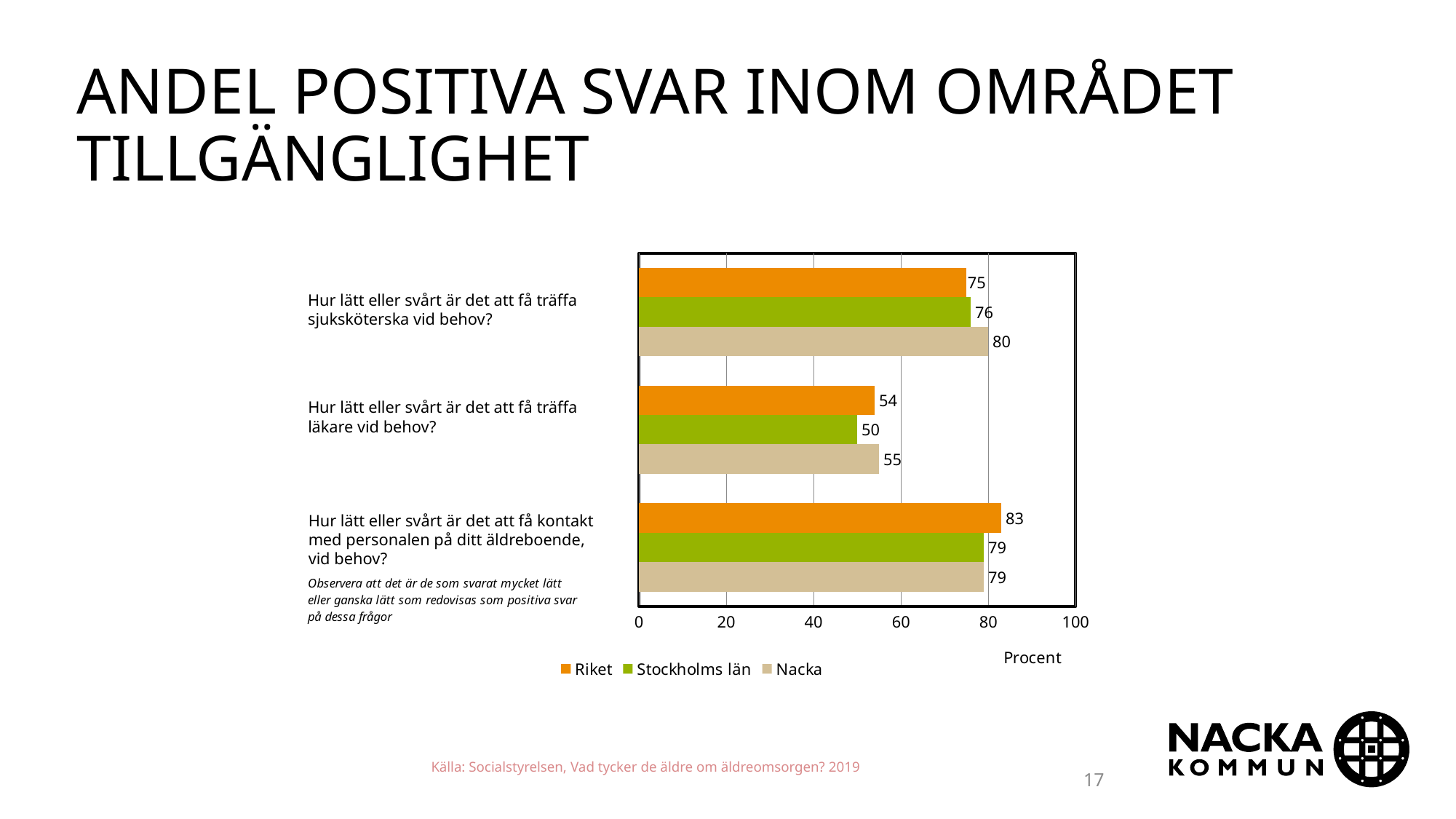
Which colour represents Riket in the legend? Orange Which is larger on the question 'Hur lätt eller svårt är det att få träffa läkare vid behov?': the value for Nacka or the value for Riket? Nacka What is the value for Nacka on the question 'Hur lätt eller svårt är det att få träffa sjuksköterska vid behov?' 80 How many series does the legend list? 3 How many questions (categories) are shown on the chart? 3 Which series has the highest value on the question 'Hur lätt eller svårt är det att få kontakt med personalen på ditt äldreboende, vid behov?' Riket What is the difference between the Nacka and Riket values on the question 'Hur lätt eller svårt är det att få träffa sjuksköterska vid behov?' 5 What kind of chart is shown on the slide? Bar chart What unit is shown on the x axis of the chart? Procent What is the value for Stockholms län on the question 'Hur lätt eller svårt är det att få kontakt med personalen på ditt äldreboende, vid behov?' 79 Which series has the lowest value on the question 'Hur lätt eller svårt är det att få träffa läkare vid behov?' Stockholms län What is the value for Riket on the question 'Hur lätt eller svårt är det att få träffa läkare vid behov?' 54